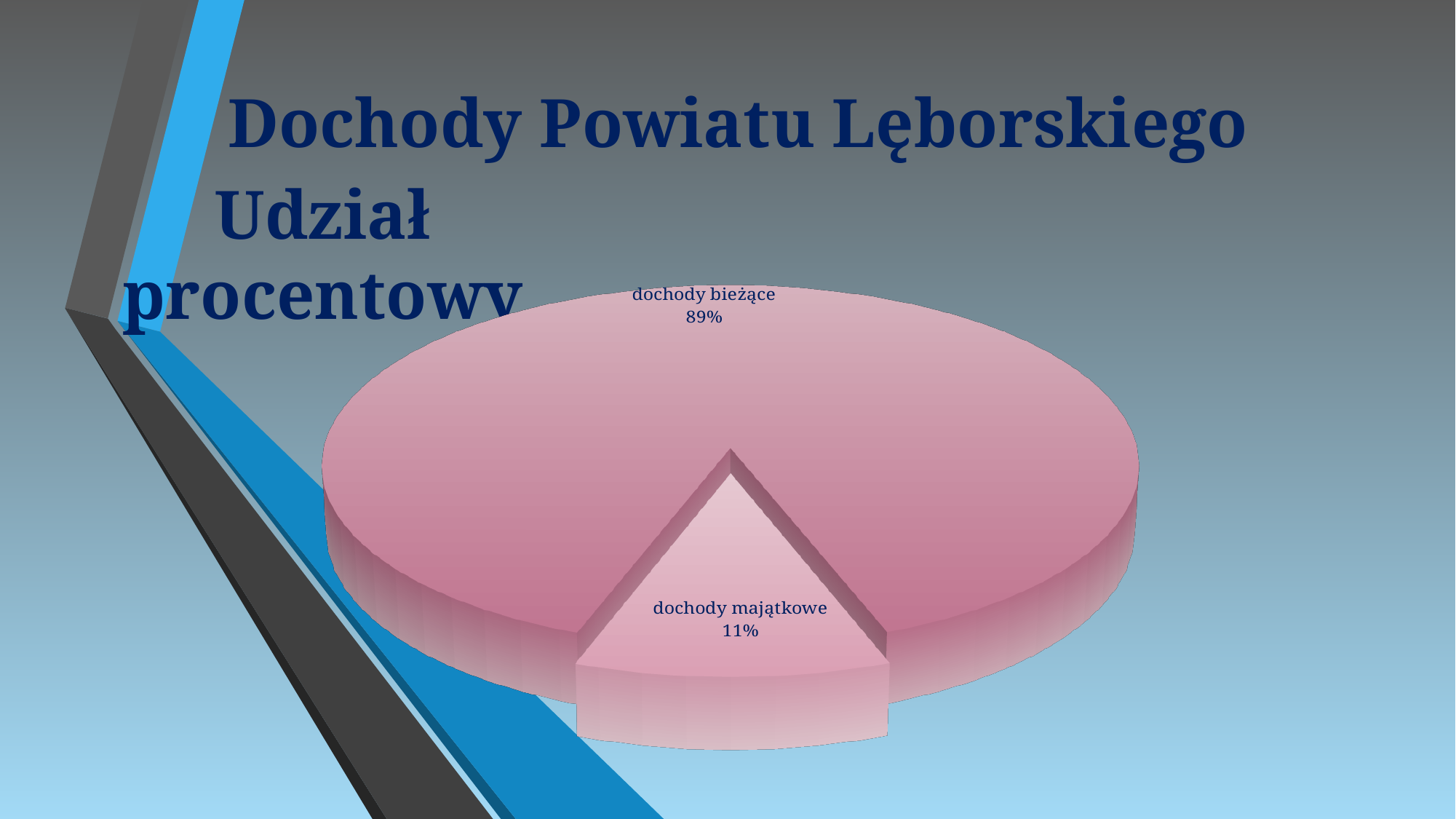
What kind of chart is shown on the slide? pie chart What is the title text shown above the chart on the slide? Dochody Powiatu Lęborskiego Udział procentowy Which slice of the pie is the largest? dochody bieżące What percentage of the pie does "dochody majątkowe" represent? 11% Which slice of the pie is the smallest? dochody majątkowe Which slice is pulled out (exploded) from the pie? dochody majątkowe How many slices does the pie chart have? 2 What percentage of the pie does "dochody bieżące" represent? 89% What is the combined percentage of the two slices in the pie chart? 100% Which is larger, the share for "dochody bieżące" or for "dochody majątkowe"? dochody bieżące What is the share of the pie taken by "dochody majątkowe"? 11% What is the difference in percentage points between "dochody bieżące" and "dochody majątkowe"? 78